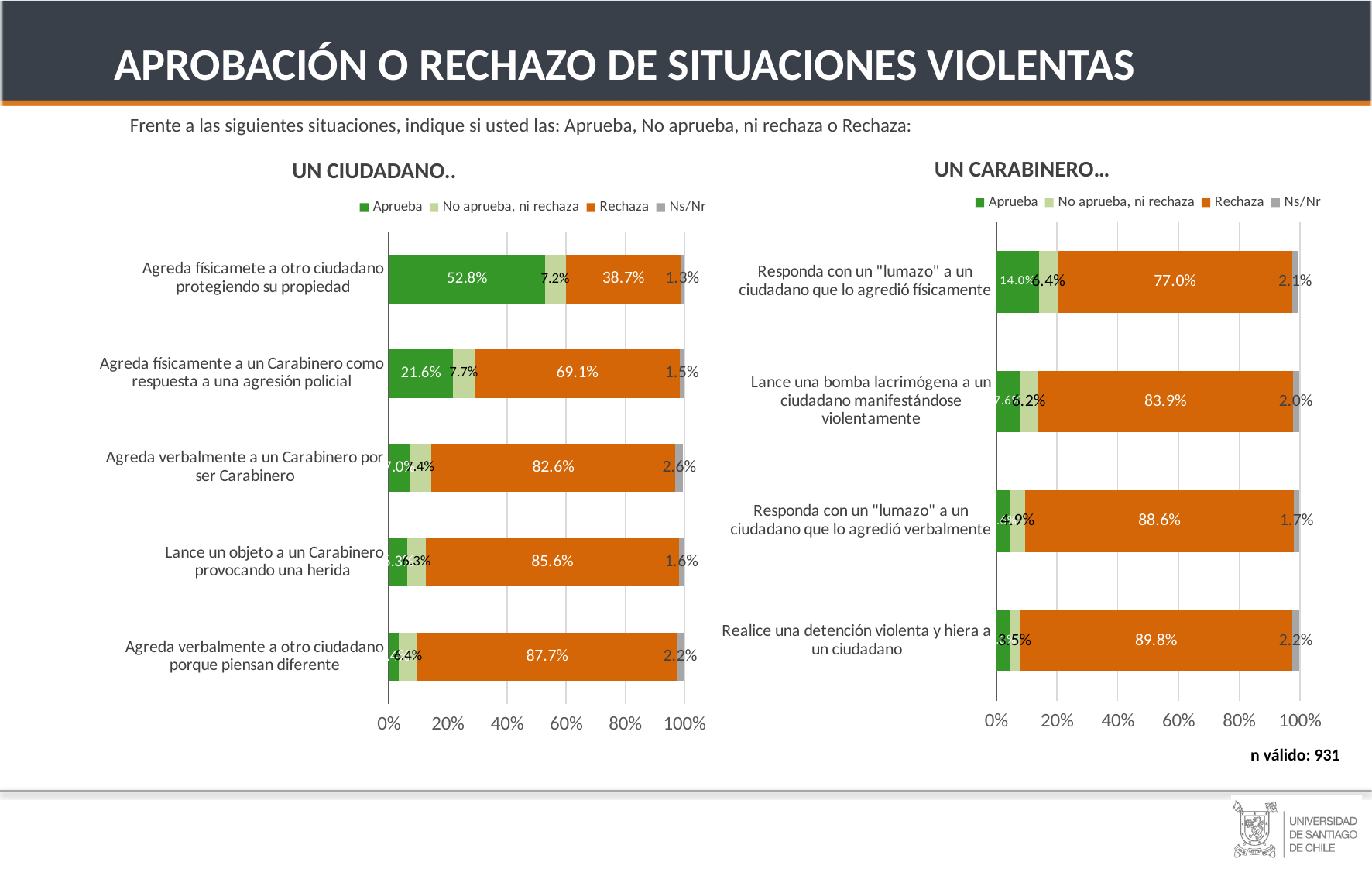
In the "UN CIUDADANO.." chart, what is the difference between the Rechaza values for "Lance un objeto a un Carabinero provocando una herida" and "Agreda verbalmente a un Carabinero por ser Carabinero"? 3.0% How many series does the legend of the "UN CIUDADANO.." chart list? 4 In the "UN CIUDADANO.." chart, which situation has the lowest Rechaza value? Agreda físicamete a otro ciudadano protegiendo su propiedad In the "UN CARABINERO..." chart, which situation has the highest Rechaza value? Realice una detención violenta y hiera a un ciudadano In the "UN CIUDADANO.." chart, what is the Aprueba value for "Agreda físicamete a otro ciudadano protegiendo su propiedad"? 52.8% How many situations are shown in the "UN CARABINERO..." chart? 4 What type of chart is the "UN CIUDADANO.." chart? Stacked bar chart In the "UN CIUDADANO.." chart, which situation has the highest Rechaza value? Agreda verbalmente a otro ciudadano porque piensan diferente In the "UN CARABINERO..." chart, what is the Aprueba value for "Responda con un "lumazo" a un ciudadano que lo agredió físicamente"? 14.0% In the "UN CARABINERO..." chart, is the Rechaza value for "Responda con un "lumazo" a un ciudadano que lo agredió verbalmente" larger or smaller than the Rechaza value for "Responda con un "lumazo" a un ciudadano que lo agredió físicamente"? larger In the "UN CARABINERO..." chart, what is the Rechaza value for "Lance una bomba lacrimógena a un ciudadano manifestándose violentamente"? 83.9% In the "UN CIUDADANO.." chart, what is the Rechaza value for "Agreda físicamente a un Carabinero como respuesta a una agresión policial"? 69.1%